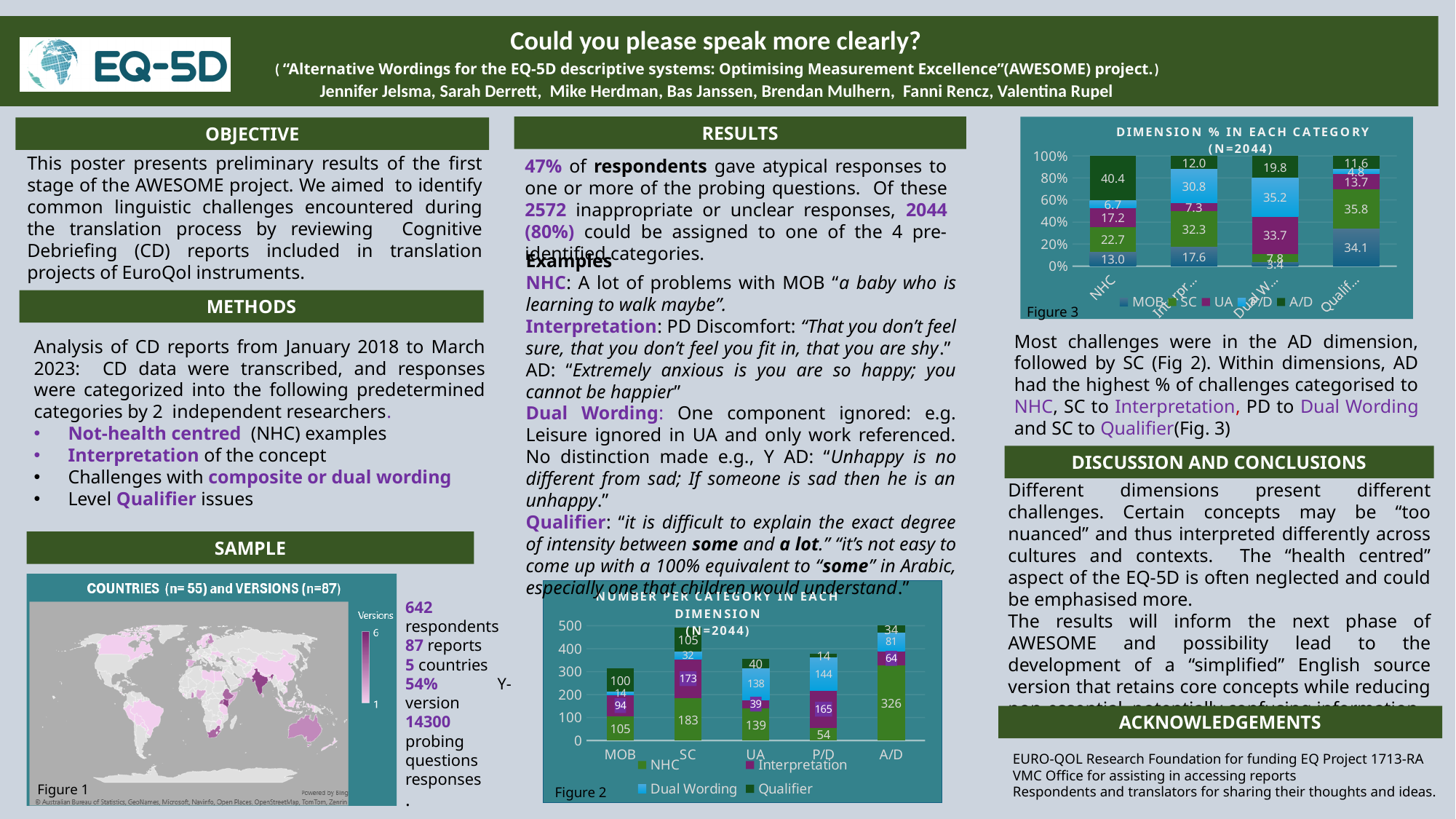
In the chart titled 'Dimension % in each category', how many categories are shown on the x axis? 4 In the chart titled 'Dimension % in each category', what is the UA value for the Dual Wording category? 33.7 In the chart titled 'Number per category in each dimension', what is the Interpretation value for P/D? 165 In the chart titled 'Number per category in each dimension', what is the NHC value for A/D? 326 In the chart titled 'Number per category in each dimension', what is the total of the stacked bar for MOB? 313 In the chart titled 'Number per category in each dimension', what kind of chart is it? Stacked bar chart In the chart titled 'Number per category in each dimension', what is the difference between the NHC values for SC and UA? 44 In the chart titled 'Number per category in each dimension', how many series does the legend list? 4 In the chart titled 'Number per category in each dimension', which dimension has the highest Qualifier value? SC In the chart titled 'Dimension % in each category', what is the A/D value for NHC? 40.4 In the chart titled 'Number per category in each dimension', what is the Dual Wording value for UA? 138 In the chart titled 'Dimension % in each category', which is larger for the Qualifier category: the MOB value or the SC value? SC